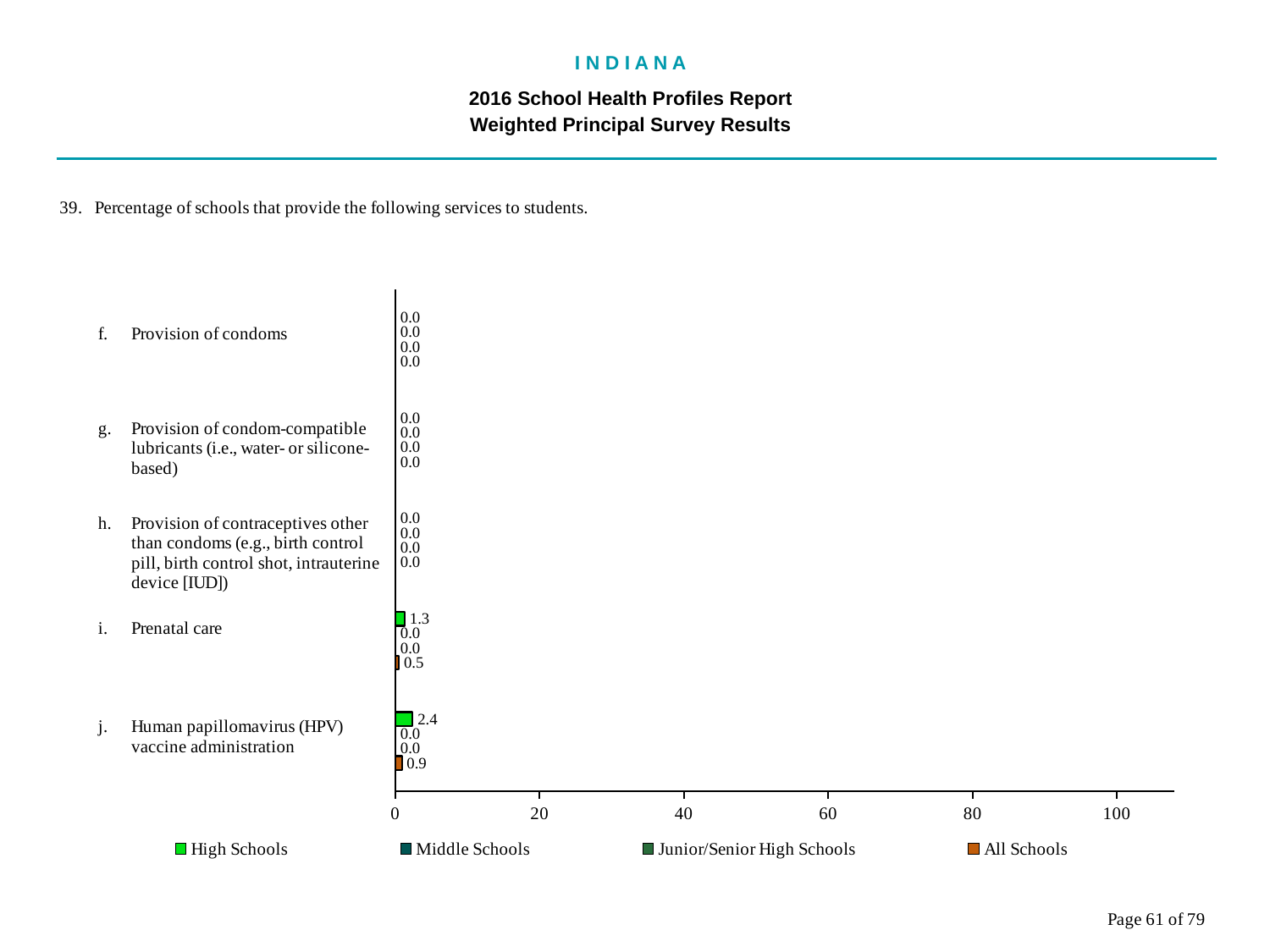
Which category has the highest value for High Schools? Human papillomavirus (HPV) vaccine administration What is the maximum value shown on the horizontal axis? 100 What is the difference between the High Schools value and the All Schools value for Human papillomavirus (HPV) vaccine administration? 1.5 What is the value for All Schools for Prenatal care? 0.5 Which is larger for Prenatal care: the High Schools value or the All Schools value? High Schools How many series does the legend list? 4 What is the value for All Schools for Human papillomavirus (HPV) vaccine administration? 0.9 What is the value for High Schools for Human papillomavirus (HPV) vaccine administration? 2.4 What is the value for High Schools for Prenatal care? 1.3 What kind of chart is shown on the slide? Bar chart How many service categories are shown on the chart? 5 What is the value for Middle Schools for Provision of condoms? 0.0